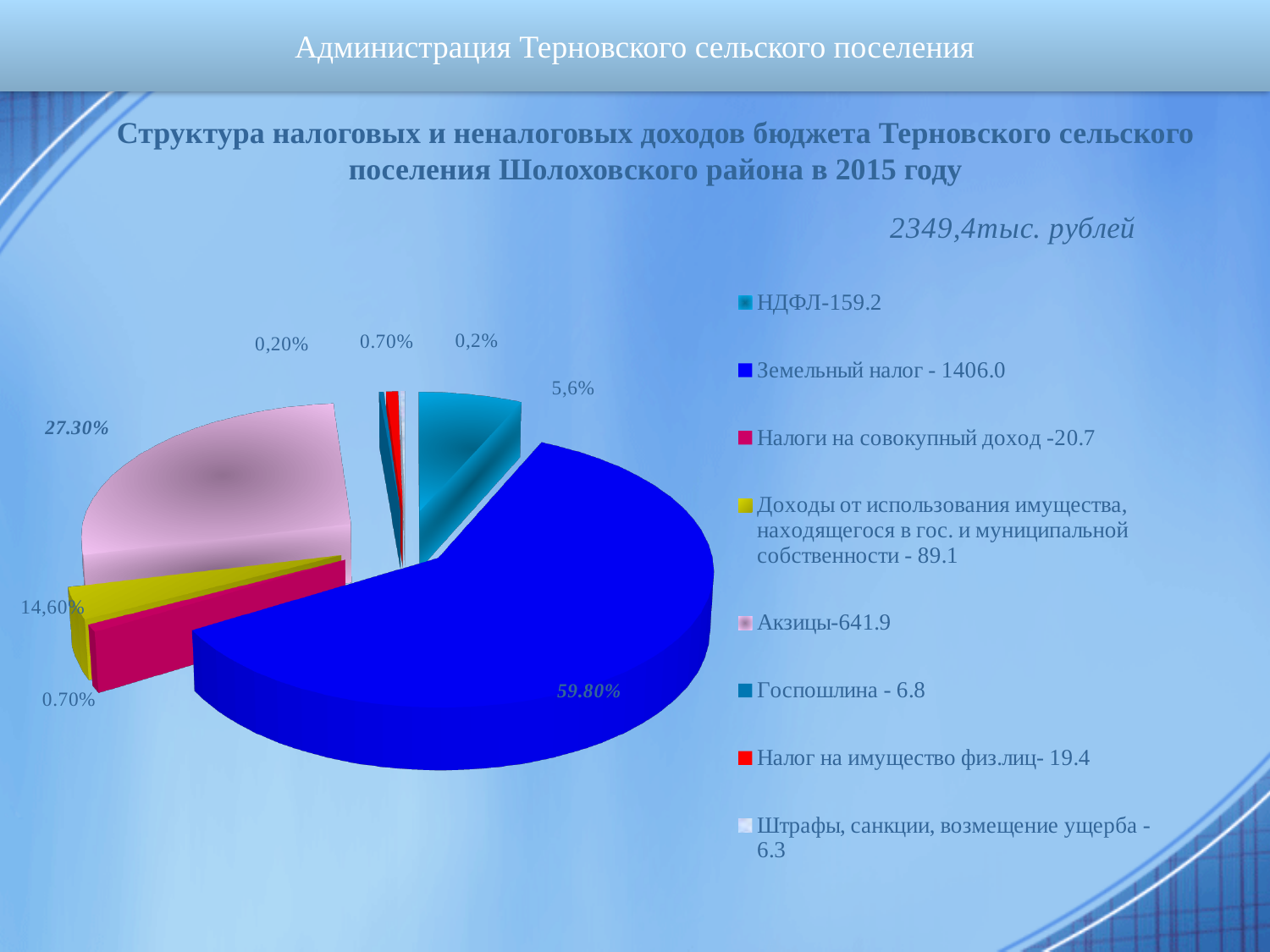
Which is larger according to the legend: Налоги на совокупный доход or Налог на имущество физ.лиц? Налоги на совокупный доход What kind of chart is shown on the slide? pie chart What value is given in the legend for Земельный налог? 1406.0 Which category has the largest slice of the pie chart? Земельный налог What value is given in the legend for НДФЛ? 159.2 What value is given in the legend for Госпошлина? 6.8 What value is given in the legend for Акзицы? 641.9 How many categories does the legend of the pie chart list? 8 What percentage label is shown on the largest (blue) slice of the pie chart? 59.80% What percentage label is shown on the pink Акзицы slice of the pie chart? 27.30% What is the difference between the legend values for Земельный налог and Акзицы? 764.1 What total amount is stated above the legend of the chart? 2349,4тыс. рублей